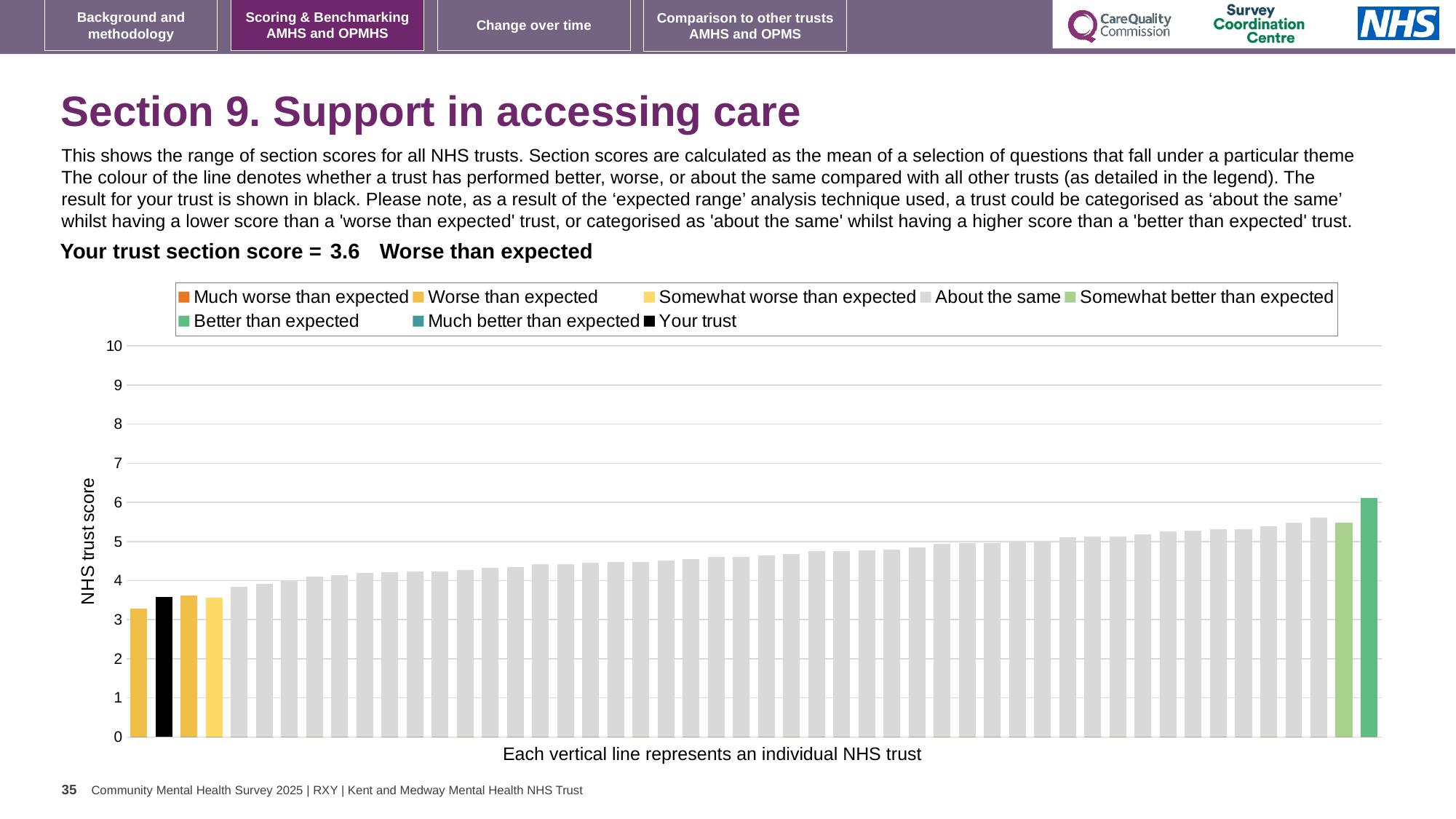
Is the value for your trust (the black bar) greater or less than 4? less Is the value of the tallest bar greater or less than 5? greater Do the bar values rise or fall from left to right along the x axis? rise What is the section score for your trust shown on the slide? 3.6 How many entries does the chart legend list? 8 How many bars are coloured black in the chart? 1 Is the value of the tallest bar greater or less than 7? less What is the label on the y axis of the chart? NHS trust score What kind of chart is shown on the slide? bar chart Which legend category does the tallest bar belong to? Better than expected Which performance category is your trust placed in for this section? Worse than expected